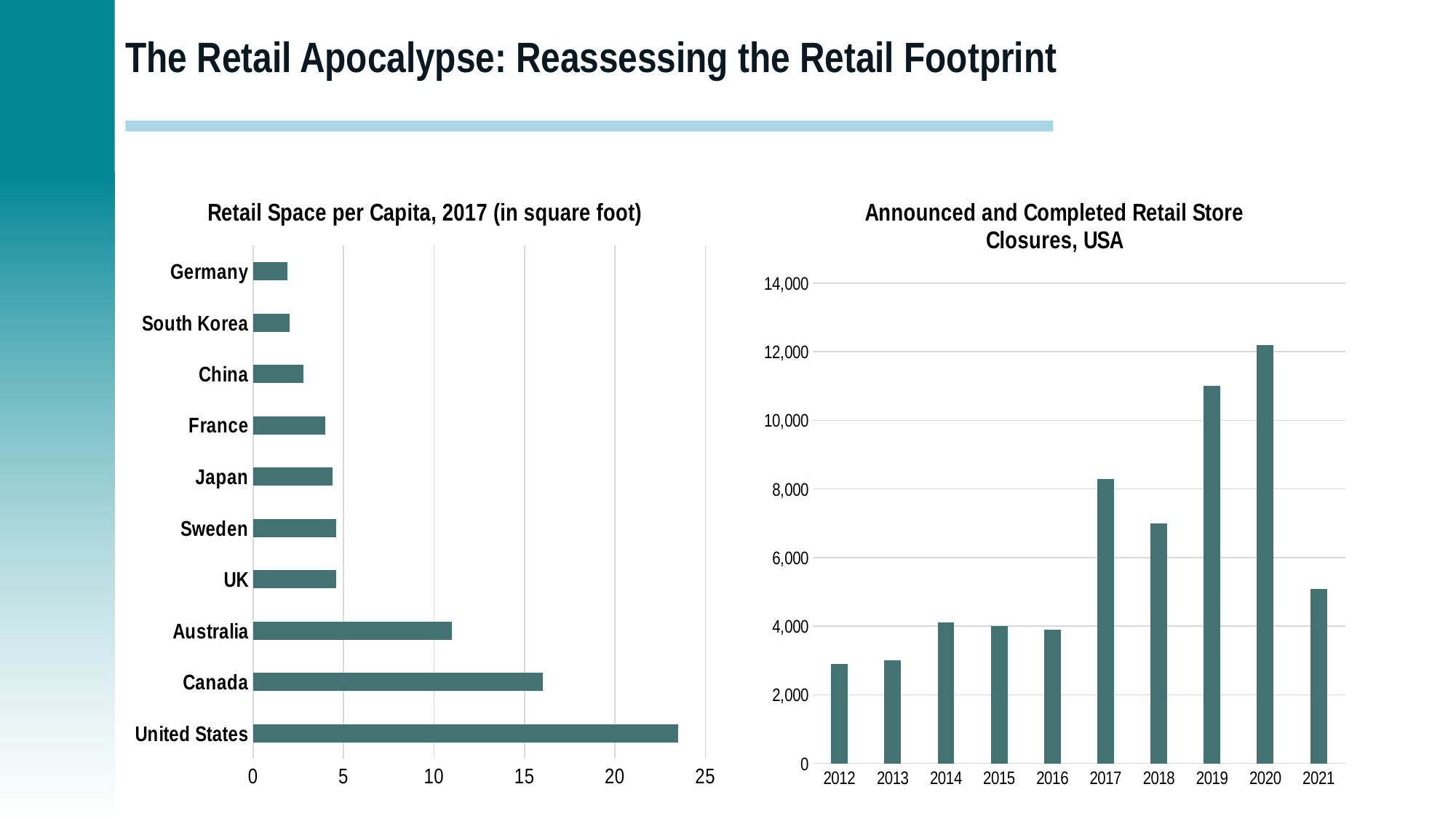
In the 'Retail Space per Capita, 2017' chart, is the value for China greater or less than 5? less In the 'Retail Space per Capita, 2017' chart, which country has the lowest value? Germany What type of chart is the 'Retail Space per Capita, 2017' chart? bar chart In the 'Announced and Completed Retail Store Closures, USA' chart, which year has a larger value, 2017 or 2018? 2017 How many years are shown in the 'Announced and Completed Retail Store Closures, USA' chart? 10 In the 'Retail Space per Capita, 2017' chart, is the value for Canada greater or less than 15? greater In the 'Announced and Completed Retail Store Closures, USA' chart, which year has the highest value? 2020 In the 'Retail Space per Capita, 2017' chart, which country has the highest value? United States In the 'Announced and Completed Retail Store Closures, USA' chart, is the value for 2019 greater or less than 10,000? greater How many countries are shown in the 'Retail Space per Capita, 2017' chart? 10 In the 'Retail Space per Capita, 2017' chart, which has a larger value, Canada or Australia? Canada